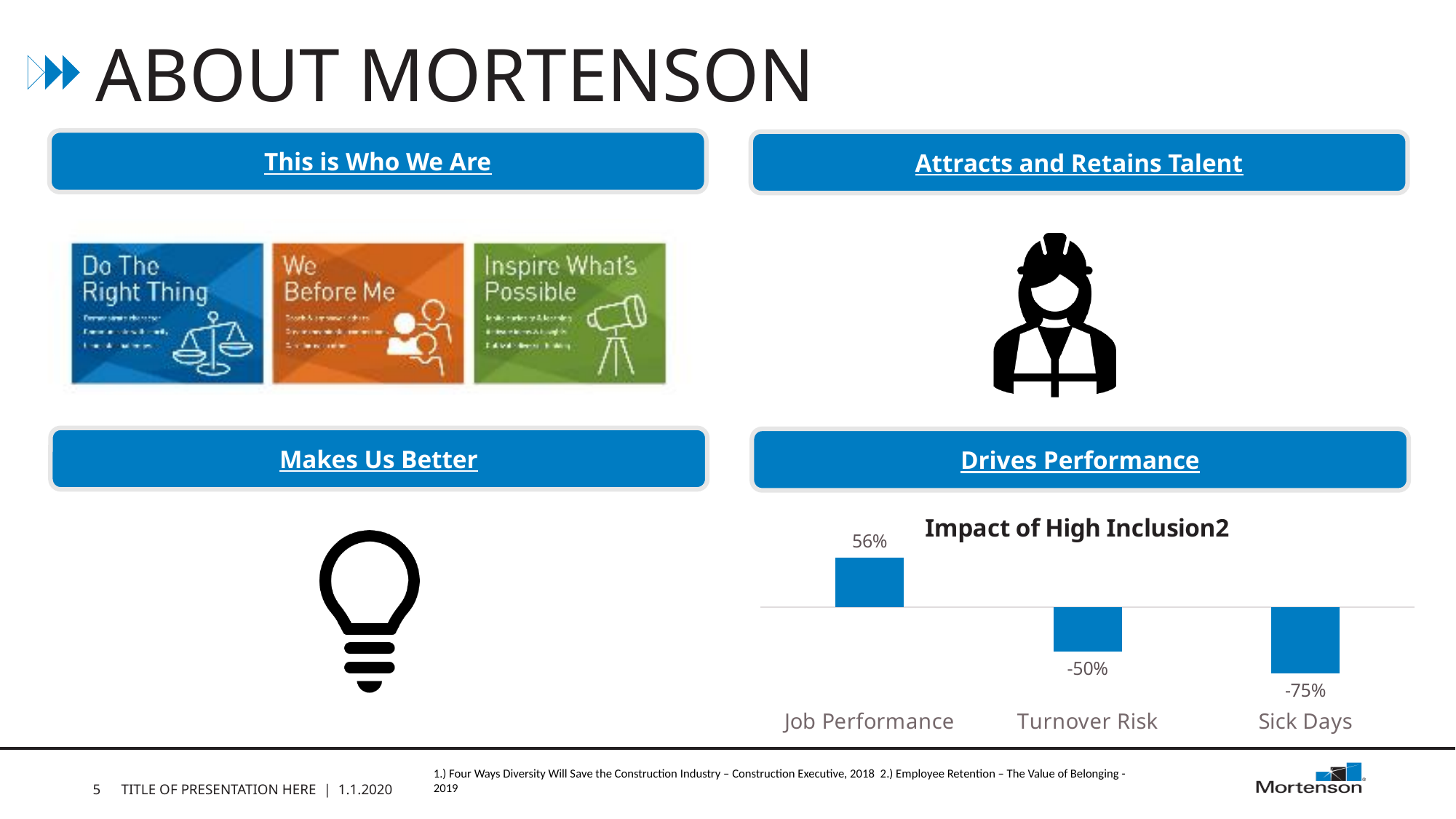
What is the value for Turnover Risk in the Impact of High Inclusion chart? -50% What is the title of the chart on the slide? Impact of High Inclusion2 Under which heading does the Impact of High Inclusion chart appear? Drives Performance How many categories are shown in the Impact of High Inclusion chart? 3 What kind of chart is the Impact of High Inclusion chart? bar chart What is the value for Job Performance in the Impact of High Inclusion chart? 56% Which is larger in the Impact of High Inclusion chart, the value for Job Performance or the value for Turnover Risk? Job Performance Which category has the highest value in the Impact of High Inclusion chart? Job Performance What is the value for Sick Days in the Impact of High Inclusion chart? -75% Do the values in the Impact of High Inclusion chart rise or fall from left to right? fall Which category has the lowest value in the Impact of High Inclusion chart? Sick Days What is the difference between the values for Turnover Risk and Sick Days in the Impact of High Inclusion chart? 25%